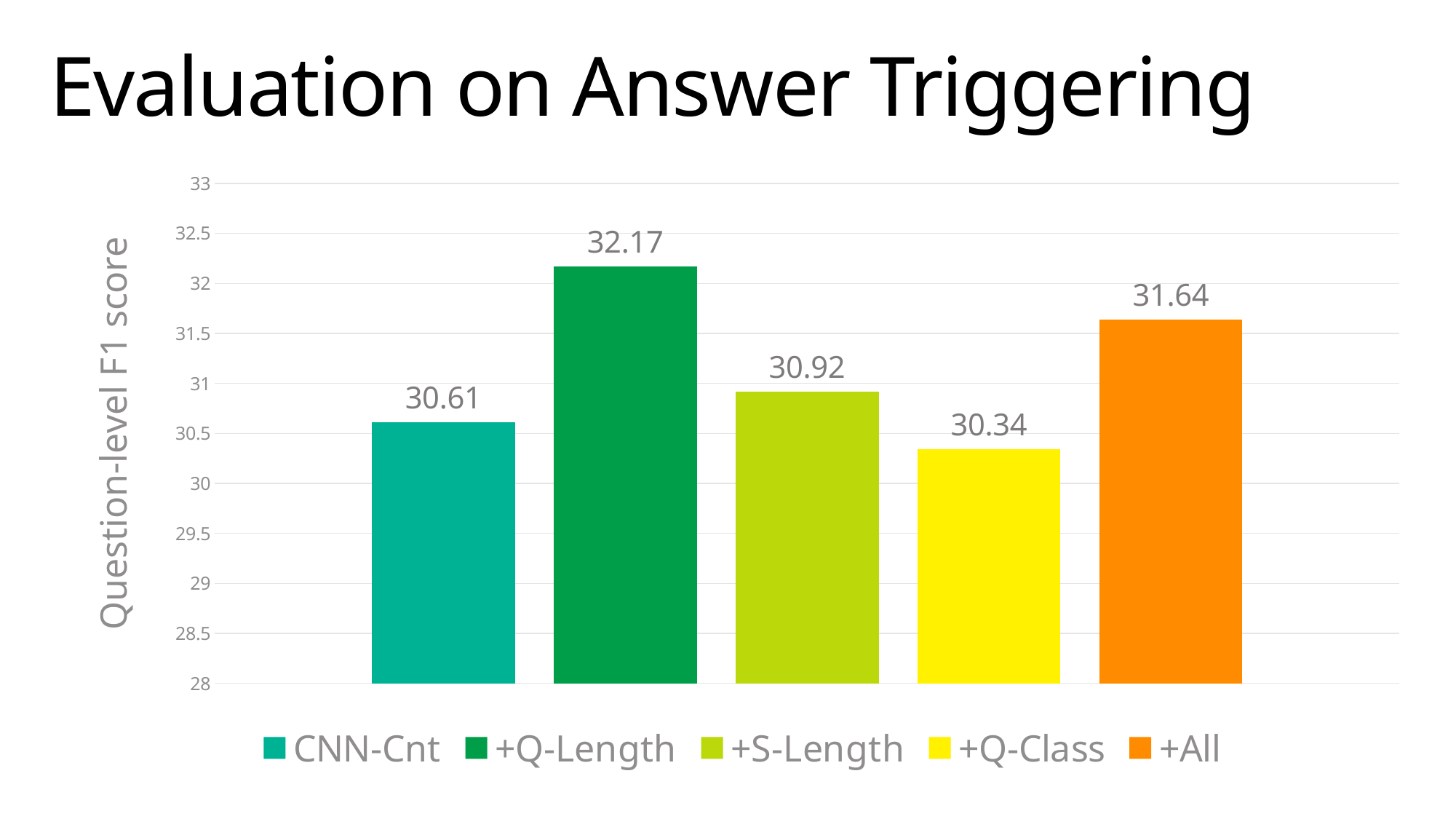
Which series has the highest Question-level F1 score? +Q-Length What is the Question-level F1 score for +Q-Length? 32.17 What is the Question-level F1 score for CNN-Cnt? 30.61 What is the difference between the F1 scores of +All and +S-Length? 0.72 Is the F1 score for +All greater or less than 31.5? greater What is the Question-level F1 score for +All? 31.64 What kind of chart is shown on the slide? bar chart Which has a higher F1 score, +S-Length or +Q-Class? +S-Length Which series has the lowest Question-level F1 score? +Q-Class What is the difference between the F1 scores of +Q-Length and CNN-Cnt? 1.56 How many bars are shown in the chart? 5 What is the label of the vertical axis? Question-level F1 score